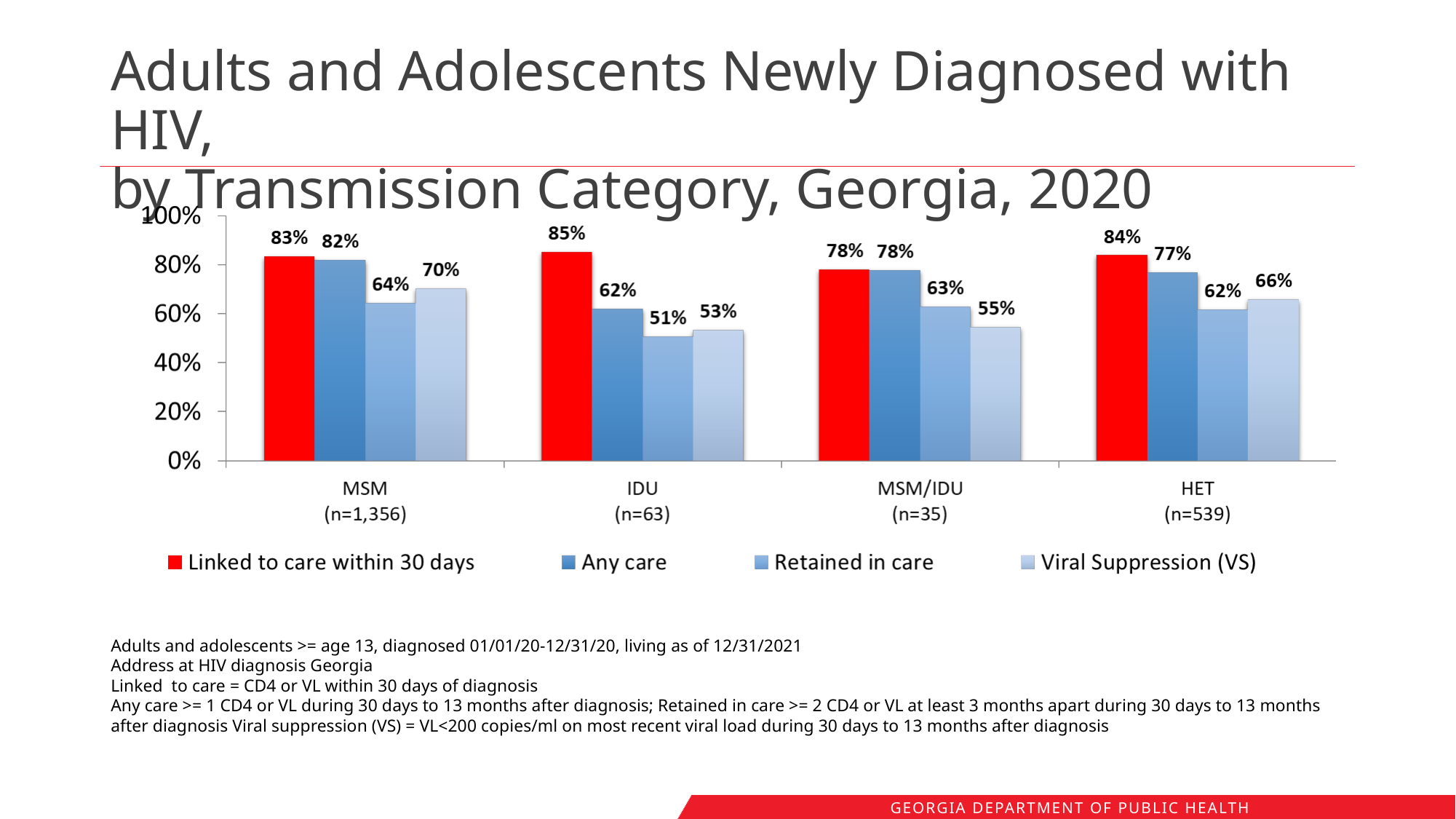
Which transmission category has the highest value for Linked to care within 30 days? IDU What kind of chart is shown on the slide? bar chart Which is larger: the Viral Suppression (VS) value for MSM or for MSM/IDU? MSM Is the Retained in care value for HET greater or less than 80%? less Which transmission category has the lowest Retained in care value? IDU What is the Retained in care value for the MSM/IDU category? 63% How many transmission categories are shown on the x axis? 4 What is the value for Linked to care within 30 days for the IDU category? 85% Which series is shown in red in the legend? Linked to care within 30 days What is the difference between the Any care value for MSM and the Any care value for IDU? 20 percentage points What is the Viral Suppression (VS) value for the HET category? 66% How many series does the legend list? 4